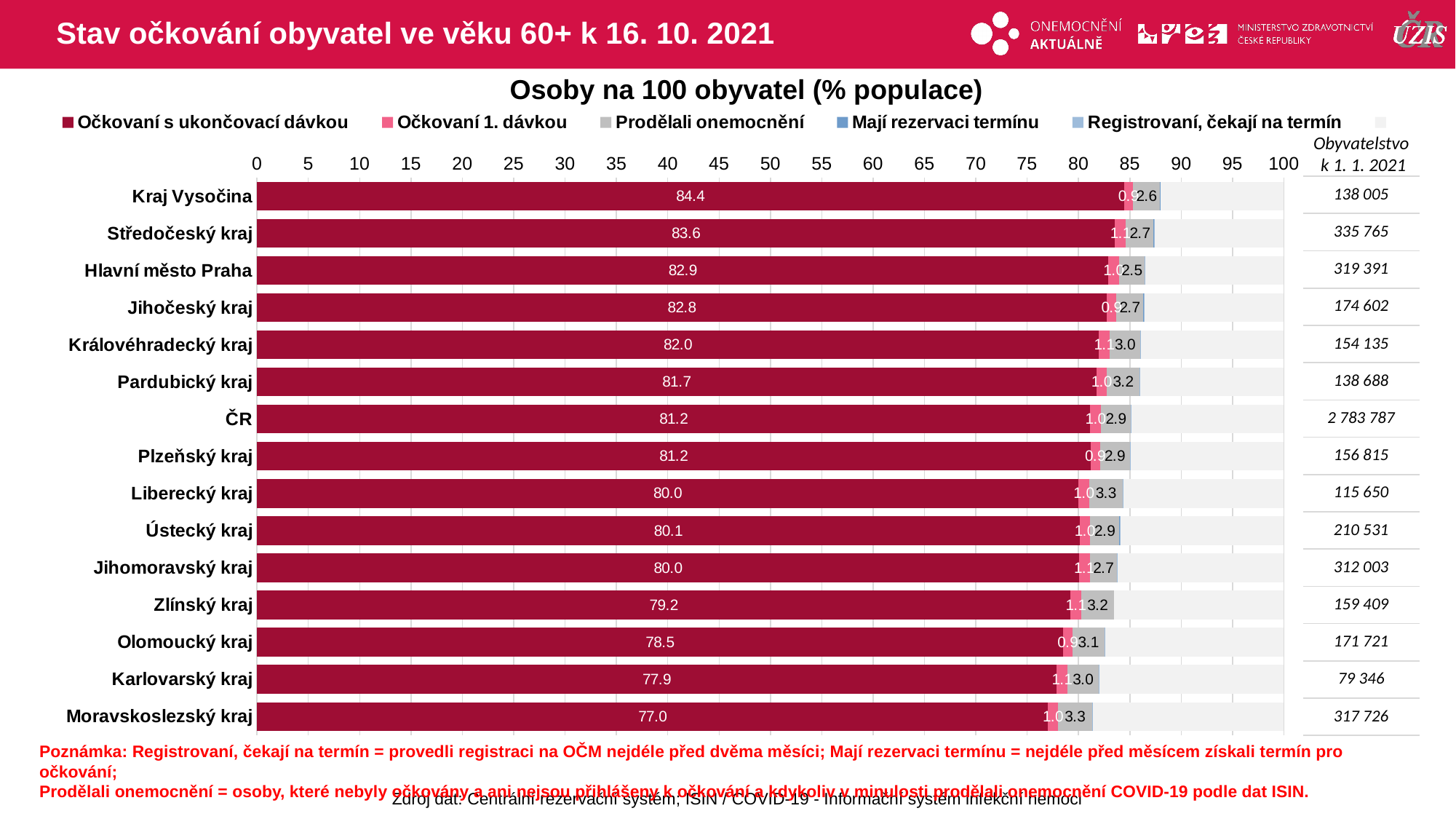
What is the title of the chart? Osoby na 100 obyvatel (% populace) How many categories (rows) are shown on the chart? 15 What kind of chart is shown on the slide? Stacked horizontal bar chart Which category has the lowest value of "Očkovaní s ukončovací dávkou"? Moravskoslezský kraj What is the difference in "Očkovaní s ukončovací dávkou" between Kraj Vysočina and Moravskoslezský kraj? 7.4 What is the value of "Očkovaní s ukončovací dávkou" for Kraj Vysočina? 84.4 Is the value of "Očkovaní s ukončovací dávkou" for Olomoucký kraj greater or less than 80? less Which category has the highest value of "Očkovaní s ukončovací dávkou"? Kraj Vysočina What is the value of "Očkovaní s ukončovací dávkou" for Moravskoslezský kraj? 77.0 Which has a larger value of "Očkovaní s ukončovací dávkou": Jihočeský kraj or Zlínský kraj? Jihočeský kraj What is the value of "Očkovaní s ukončovací dávkou" for ČR? 81.2 What is the value of "Prodělali onemocnění" for Pardubický kraj? 3.2